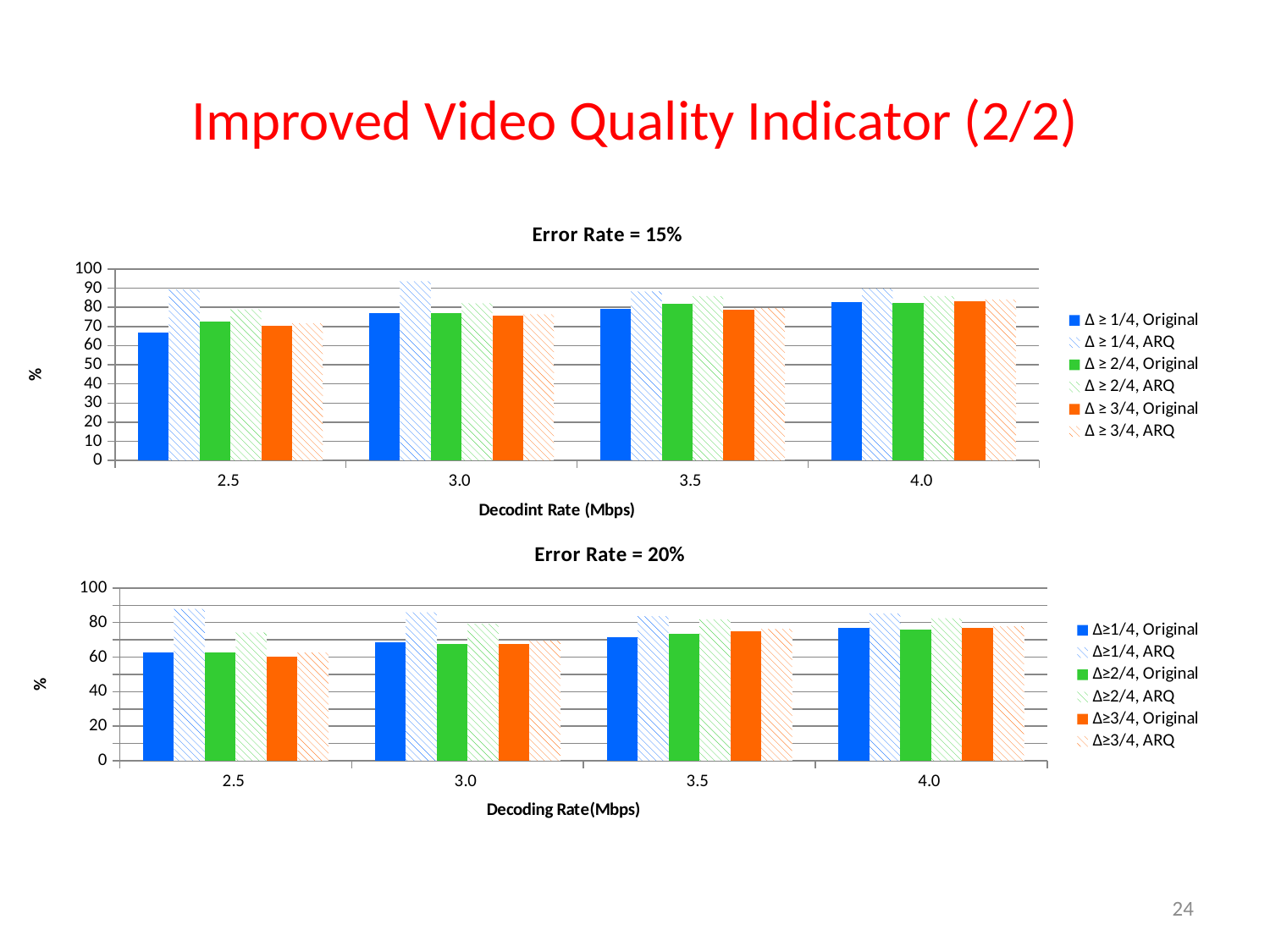
In the 'Error Rate = 15%' chart, is the value for 'Δ ≥ 1/4, Original' at 2.5 Mbps greater or less than 80? less In the 'Error Rate = 20%' chart, is the value for 'Δ≥1/4, Original' at 2.5 Mbps greater or less than 80? less In the 'Error Rate = 20%' chart, do the values for 'Δ≥3/4, Original' rise or fall as the decoding rate increases from 2.5 to 4.0 Mbps? rise In the 'Error Rate = 15%' chart, which is larger at 3.0 Mbps: 'Δ ≥ 1/4, Original' or 'Δ ≥ 1/4, ARQ'? Δ ≥ 1/4, ARQ In the 'Error Rate = 20%' chart, what is the y-axis label? % In the 'Error Rate = 20%' chart, is the value for 'Δ≥1/4, ARQ' at 2.5 Mbps greater or less than 80? greater In the 'Error Rate = 15%' chart, what kind of chart is shown? bar chart In the 'Error Rate = 15%' chart, how many decoding rate categories are shown on the x axis? 4 In the 'Error Rate = 15%' chart, what is the x-axis title? Decodint Rate (Mbps) In the 'Error Rate = 15%' chart, how many series does the legend list? 6 In the 'Error Rate = 15%' chart, do the values for 'Δ ≥ 1/4, Original' rise or fall as the decoding rate increases from 2.5 to 4.0 Mbps? rise